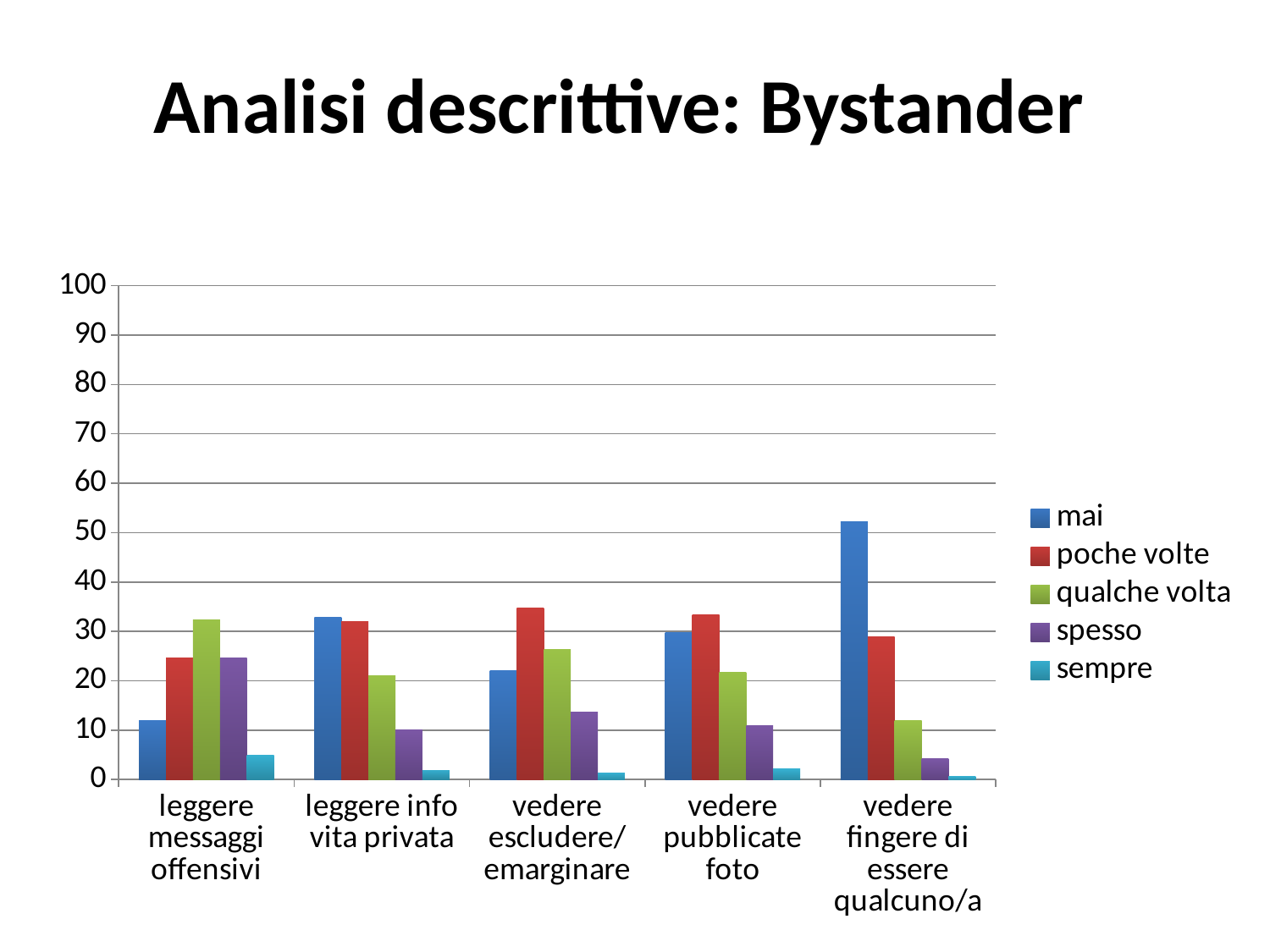
In the category 'leggere messaggi offensivi', which is larger: 'mai' or 'qualche volta'? qualche volta Is the value for 'poche volte' in the category 'vedere escludere/emarginare' greater or less than 30? greater Which category has the highest bar for the series 'mai'? vedere fingere di essere qualcuno/a What is the title of the slide? Analisi descrittive: Bystander How many series does the legend list? 5 Is the value for 'mai' in the category 'vedere fingere di essere qualcuno/a' greater or less than 50? greater How many categories are shown along the x axis? 5 Which series is shown in red in the legend? poche volte What kind of chart is shown on the slide? bar chart In the category 'vedere fingere di essere qualcuno/a', which is larger: 'mai' or 'poche volte'? mai Is the value for 'mai' in the category 'leggere messaggi offensivi' greater or less than 20? less Which series has the lowest bar in every category? sempre